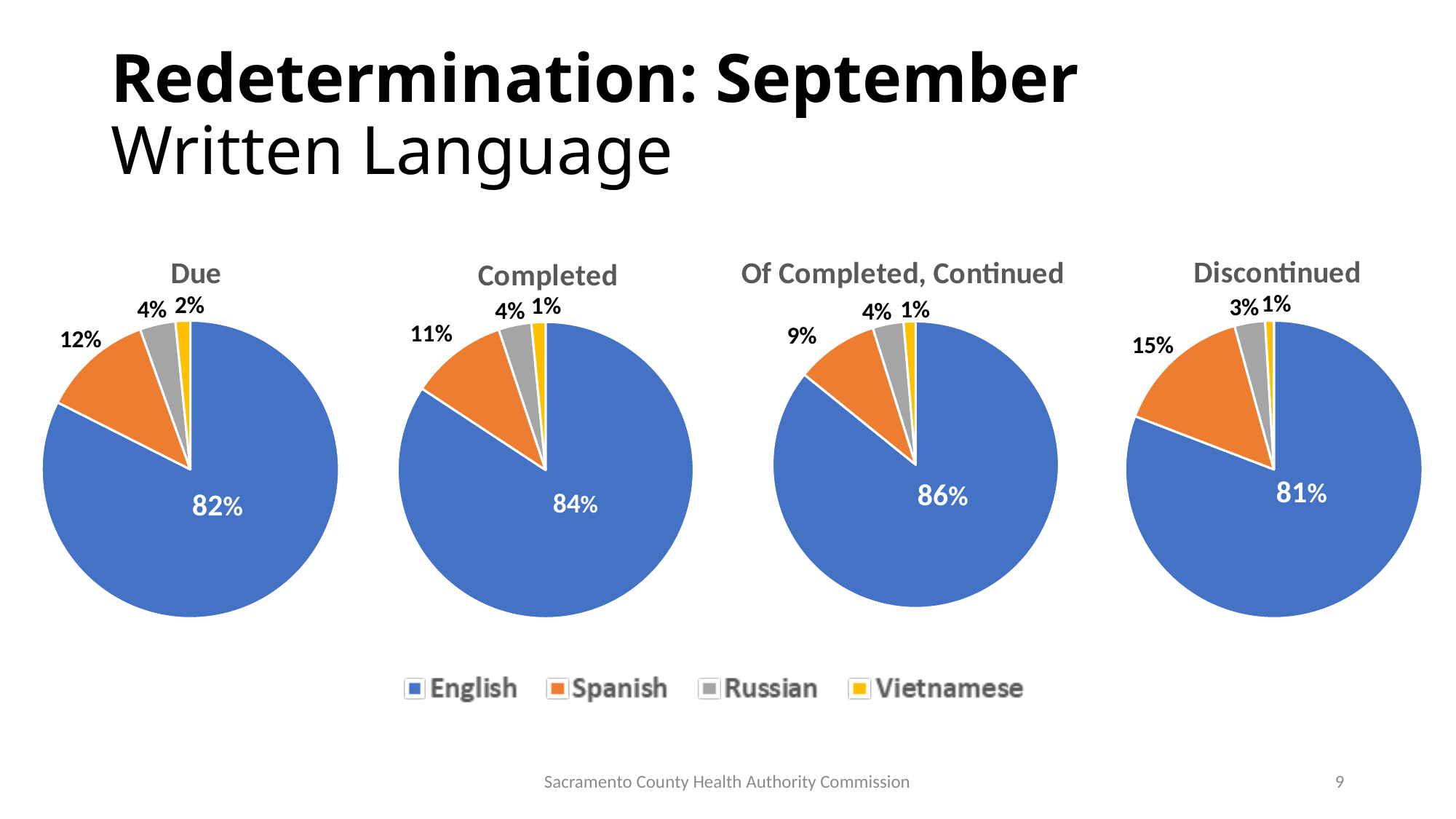
In the 'Due' pie chart, what share is English? 82% In the 'Discontinued' pie chart, what share is Spanish? 15% In the 'Of Completed, Continued' pie chart, what share is English? 86% Is the Spanish share larger in the 'Discontinued' chart or the 'Of Completed, Continued' chart? Discontinued In the 'Discontinued' pie chart, which language has the smallest slice? Vietnamese In the 'Completed' pie chart, which language has the largest slice? English How many languages does the legend list? 4 In the 'Of Completed, Continued' pie chart, what is the difference between the English and Spanish shares? 77% What kind of chart is used for the 'Due' data? Pie chart